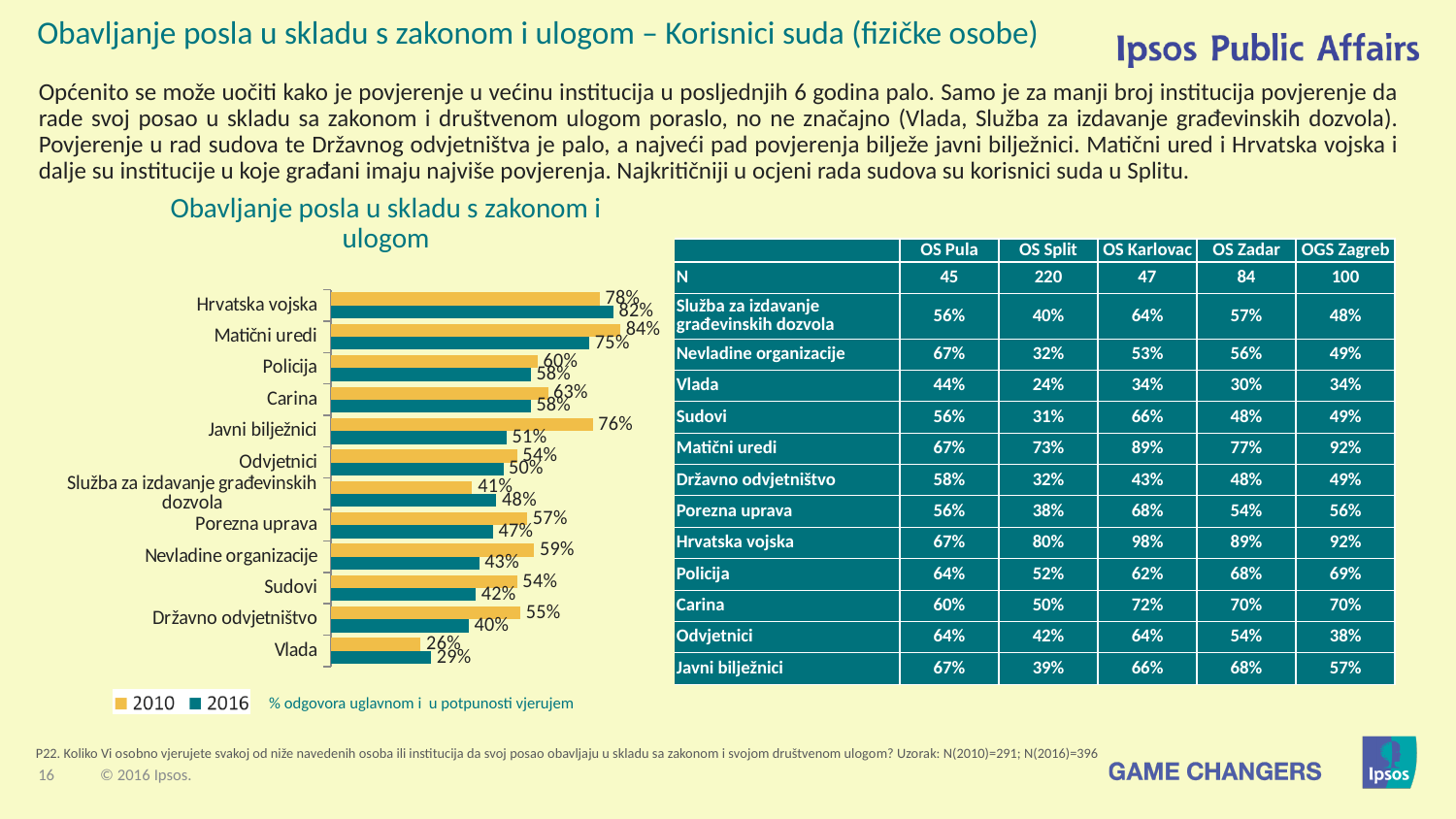
Which institution has the lowest 2010 value in the bar chart? Vlada How many institutions (categories) are shown in the bar chart? 12 How many series does the chart legend list? 2 For Matični uredi, which year has the larger value, 2010 or 2016? 2010 What is the 2016 value for Hrvatska vojska in the bar chart? 82% What type of chart is shown on the slide? bar chart Which colour represents the 2010 series in the bar chart? yellow Which institution has the highest 2016 value in the bar chart? Hrvatska vojska What is the 2016 value for Vlada in the bar chart? 29% What is the 2010 value for Javni bilježnici in the bar chart? 76% What is the difference between the 2010 and 2016 values for Državno odvjetništvo? 15% What is the difference between the 2010 and 2016 values for Javni bilježnici? 25%